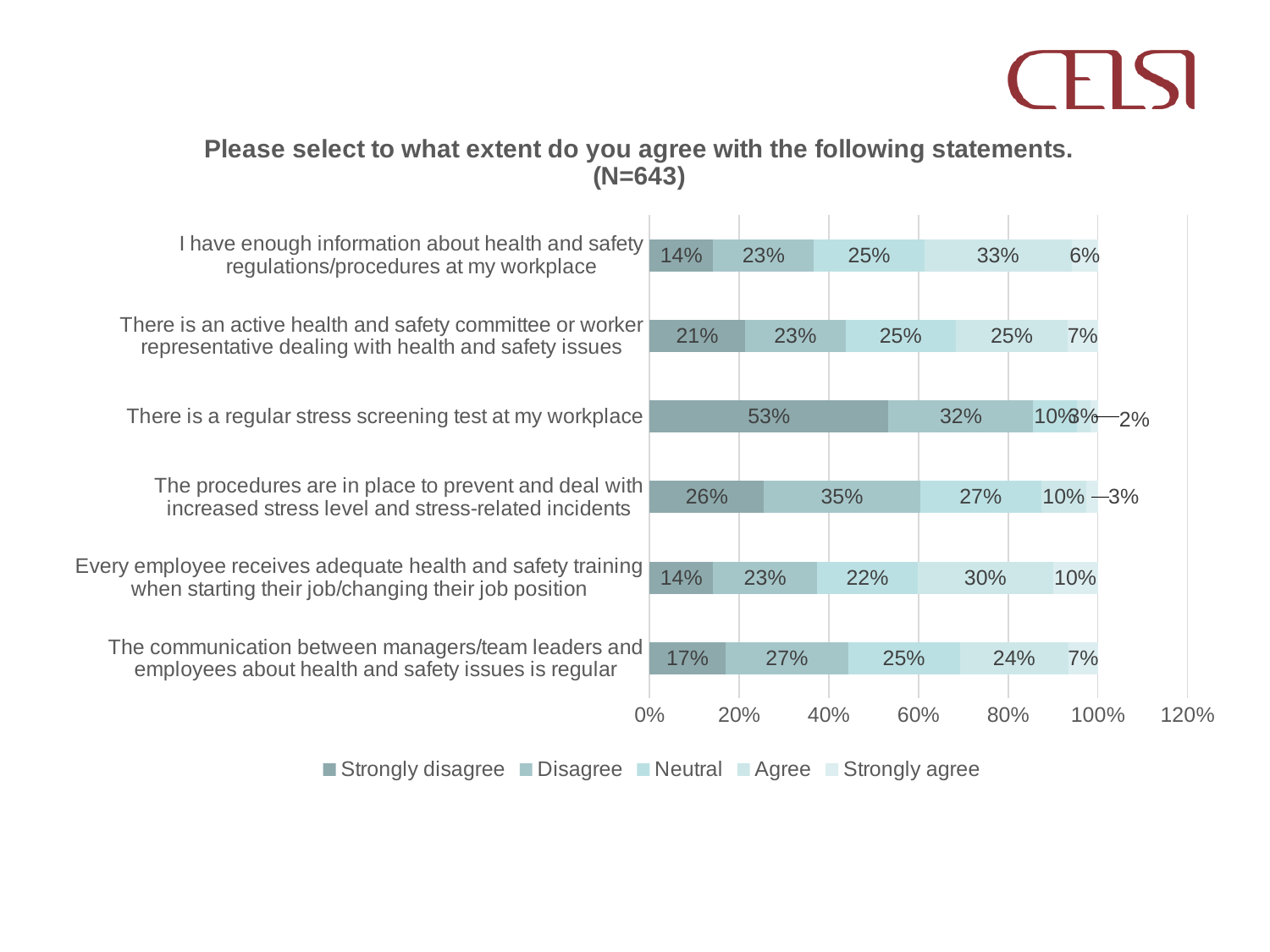
What type of chart is shown on the slide? Stacked bar chart How many statements are shown in the chart? 6 What is the Neutral percentage for the statement about communication between managers/team leaders and employees about health and safety issues? 25% What percentage of respondents strongly disagree that there is a regular stress screening test at their workplace? 53% What is the Strongly agree percentage for the statement 'Every employee receives adequate health and safety training when starting their job/changing their job position'? 10% How many response categories does the legend list? 5 Which statement has a higher Agree percentage: the one about adequate health and safety training or the one about regular communication between managers and employees? Every employee receives adequate health and safety training when starting their job/changing their job position Which statement has the lowest Strongly agree percentage? There is a regular stress screening test at my workplace Which statement has the highest Strongly agree percentage? Every employee receives adequate health and safety training when starting their job/changing their job position What is the Agree percentage for the statement 'I have enough information about health and safety regulations/procedures at my workplace'? 33% For the statement about procedures to prevent and deal with increased stress level, how many percentage points higher is Disagree than Strongly disagree? 9 percentage points Which statement has the highest Strongly disagree percentage? There is a regular stress screening test at my workplace